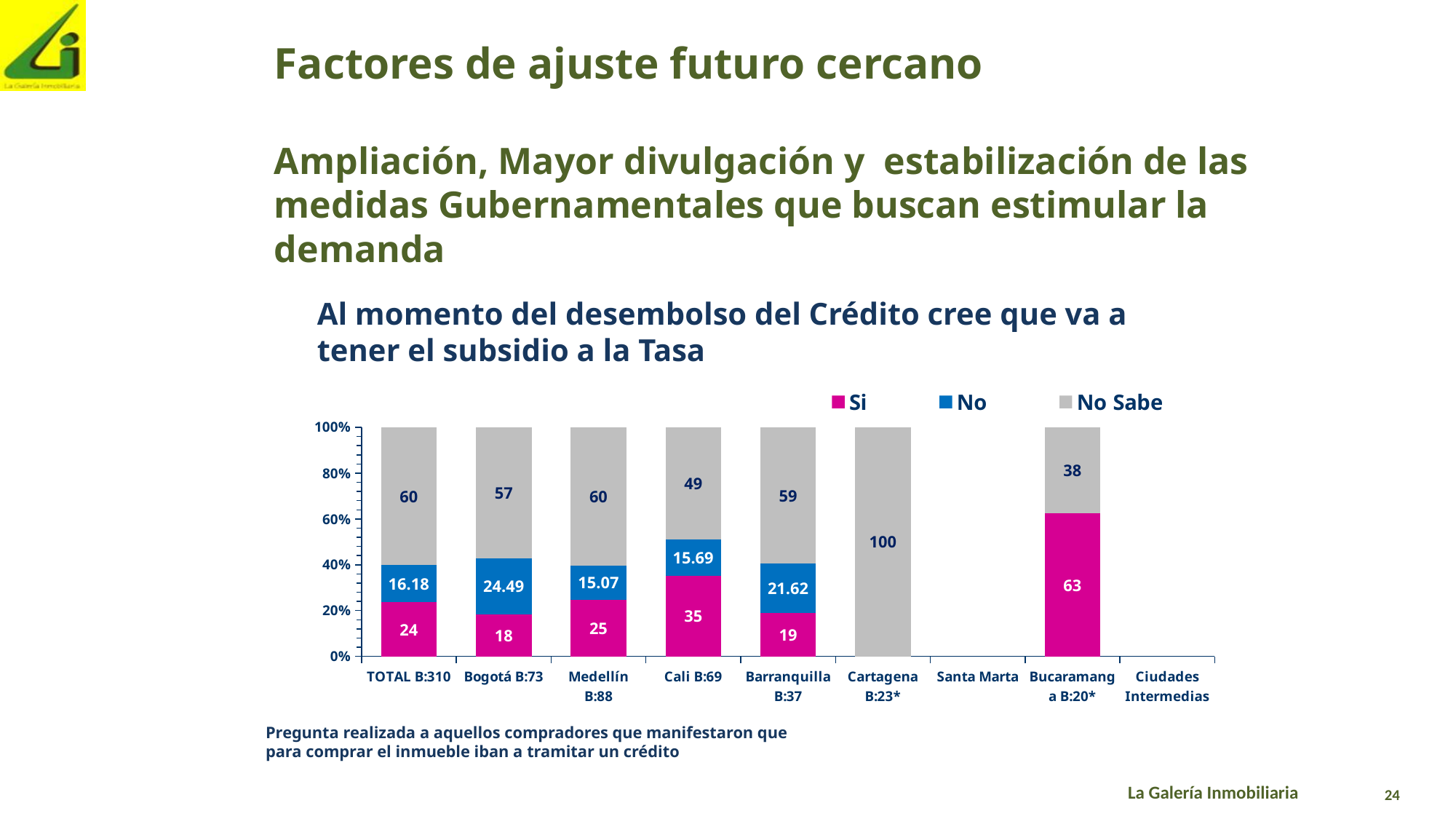
How many categories are shown on the x axis of the chart? 9 How many series does the legend list? 3 What is the "No Sabe" value for Bucaramanga B:20*? 38 Which colour represents the "Si" series in the legend? Magenta (pink) What is the "No" value for Bogotá B:73? 24.49 What kind of chart is shown on the slide? Stacked bar chart What is the "Si" value for Cali B:69? 35 Among the categories with a "Si" value shown, which has the lowest "Si" value? Bogotá B:73 Which is larger, the "No" value for Medellín B:88 or the "No" value for Bogotá B:73? Bogotá B:73 What is the "No" value for Barranquilla B:37? 21.62 Which category has the highest "Si" value? Bucaramanga B:20* What is the difference between the "Si" value for Cali B:69 and the "Si" value for Bogotá B:73? 17